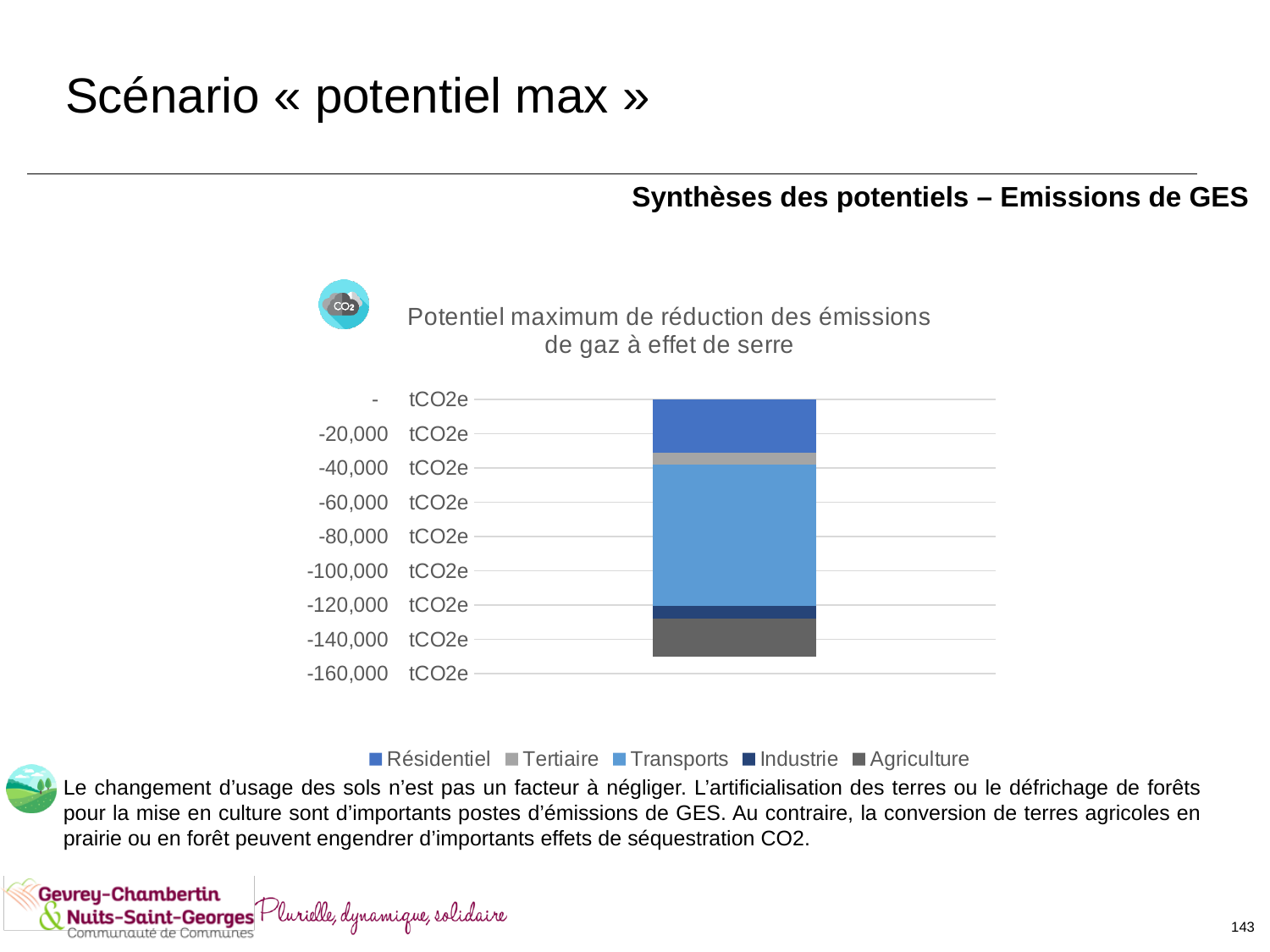
How many stacked bars are plotted in the chart? 1 Does the Transports segment span more or less than 60,000 tCO2e on the axis? more Which series is listed last in the chart legend? Agriculture Which series accounts for the largest segment of the stacked bar? Transports What is the lowest value labelled on the vertical axis? -160,000 tCO2e Which segment is larger in the stacked bar, Transports or Résidentiel? Transports How many series does the chart legend list? 5 What is the title of the chart? Potentiel maximum de réduction des émissions de gaz à effet de serre What kind of chart is shown on the slide? Stacked bar chart Which segment is larger in the stacked bar, Résidentiel or Agriculture? Résidentiel Does the bottom of the stacked bar lie above or below the -140,000 tCO2e gridline? below What unit is shown on the vertical axis of the chart? tCO2e